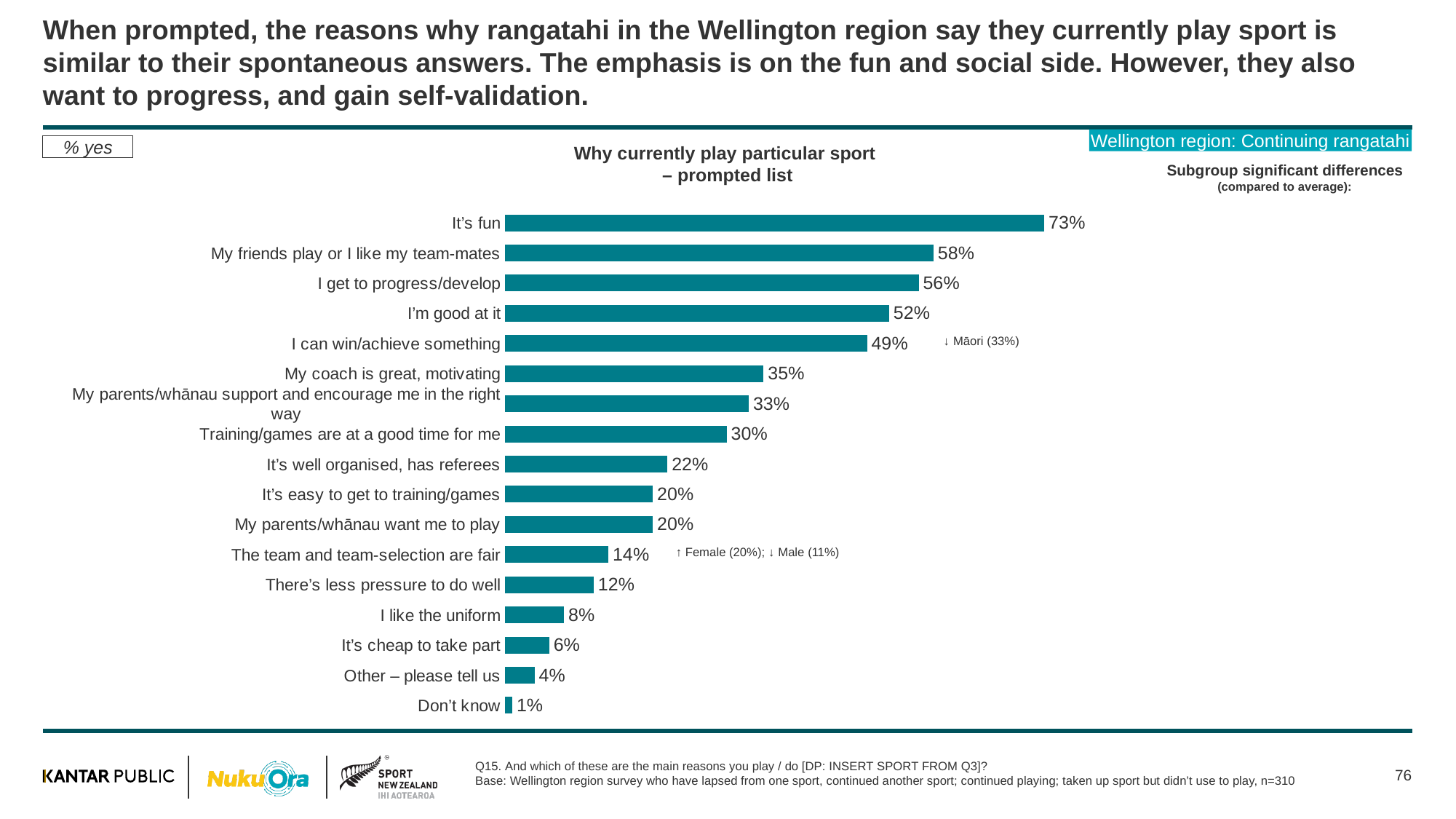
What is the value for "It's cheap to take part"? 6% What is the difference between "It's fun" and "My friends play or I like my team-mates"? 15% What is the value for "I get to progress/develop"? 56% What percentage say "My coach is great, motivating"? 35% Which is larger: "I'm good at it" or "I can win/achieve something"? I'm good at it What is the title of the chart? Why currently play particular sport – prompted list What percentage of respondents say they currently play sport because it's fun? 73% What subgroup significant difference is noted next to "I can win/achieve something"? ↓ Māori (33%) What kind of chart is shown on the slide? Bar chart How many categories are shown in the chart? 17 Which reason has the highest percentage? It's fun Which category has the lowest percentage? Don't know